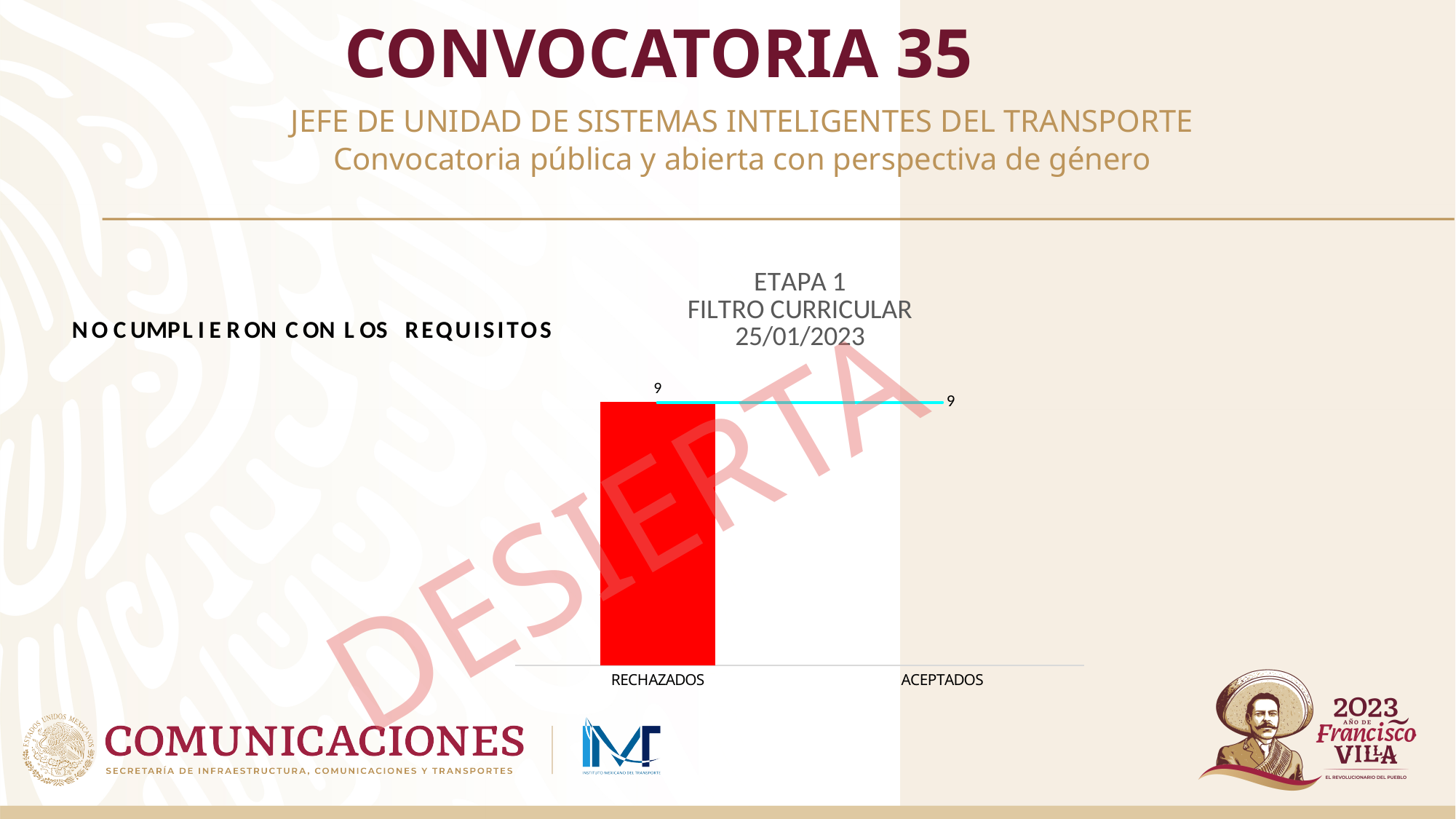
What date appears in the chart title? 25/01/2023 Which category has the highest bar? RECHAZADOS Which is larger, the value for RECHAZADOS or the value for ACEPTADOS? RECHAZADOS What kind of chart is shown on the slide? Combination bar and line chart What are the two category labels on the x axis? RECHAZADOS and ACEPTADOS What value is labelled at the right end of the horizontal line in the chart? 9 What is the value of the RECHAZADOS bar? 9 How many categories are shown on the x axis? 2 Which category has the lowest value? ACEPTADOS